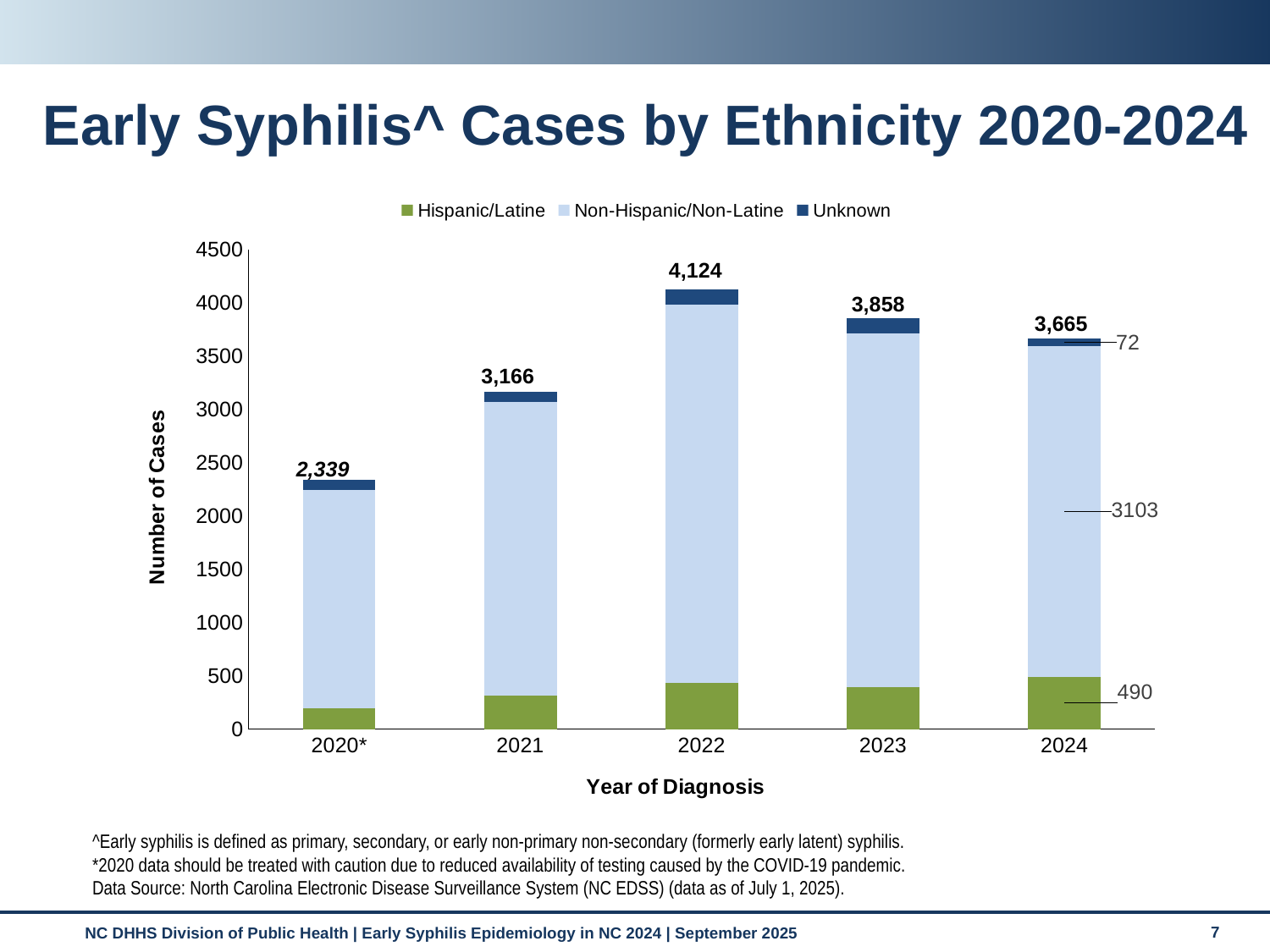
What is the difference between the total cases in 2022 and 2023? 266 How many Hispanic/Latine early syphilis cases are labeled for 2024? 490 How many cases of Unknown ethnicity are labeled for 2024? 72 Which year had more total early syphilis cases, 2021 or 2024? 2024 How many series does the legend list? 3 What type of chart is shown on the slide? Stacked bar chart How many years are shown on the x axis? 5 What is the total number of early syphilis cases shown for 2022? 4,124 How many Non-Hispanic/Non-Latine early syphilis cases are labeled for 2024? 3103 What is the total number of early syphilis cases shown for 2020*? 2,339 Which year has the lowest total number of early syphilis cases? 2020* Which year has the highest total number of early syphilis cases? 2022